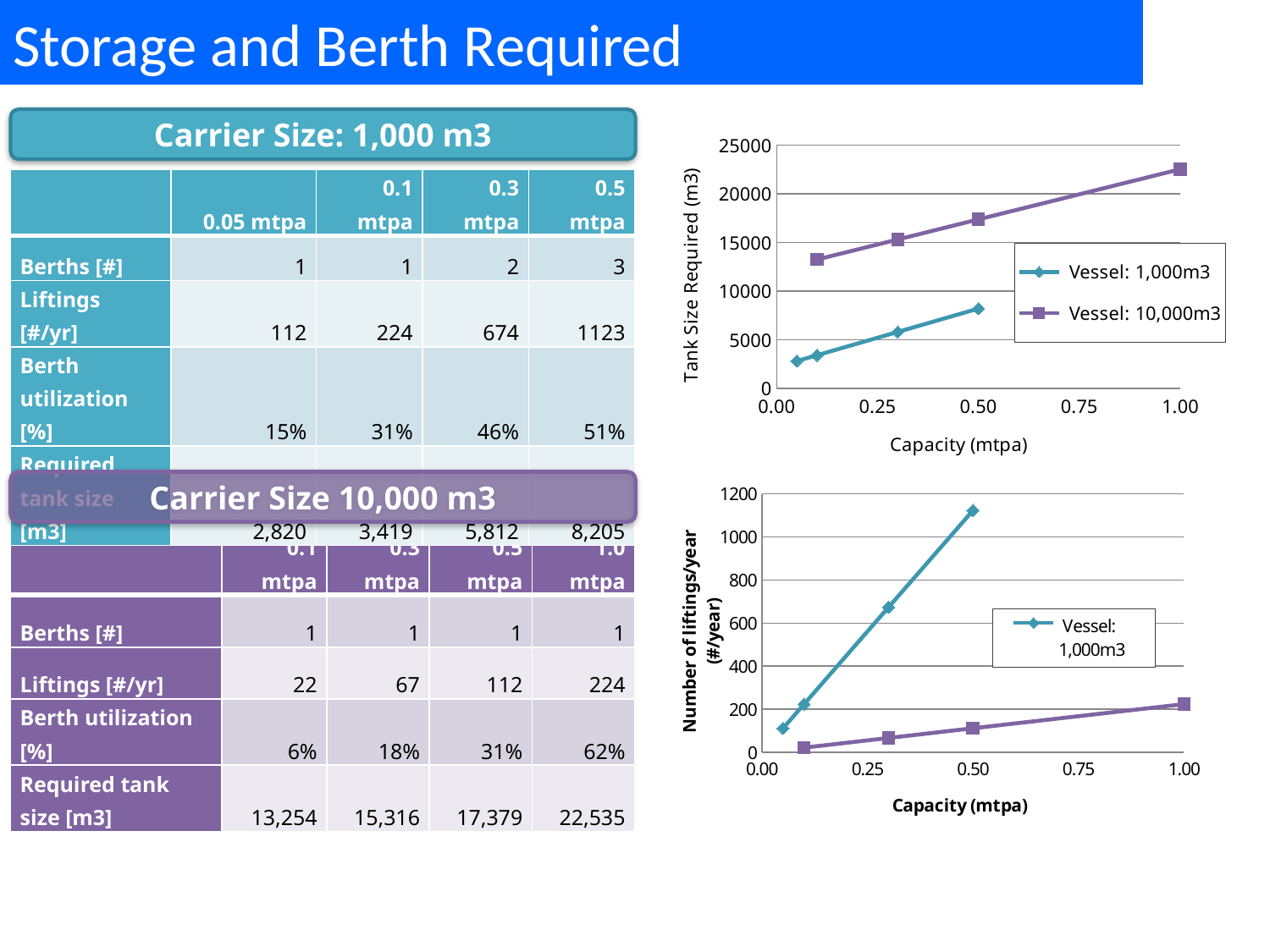
In the top chart (Tank Size Required), which series has the higher value at a capacity of 0.50 mtpa, Vessel: 1,000m3 or Vessel: 10,000m3? Vessel: 10,000m3 In the bottom chart (Number of liftings/year), do the values for Vessel: 1,000m3 rise or fall as capacity increases? rise In the top chart (Tank Size Required), how many data points are plotted for the Vessel: 1,000m3 series? 4 What kind of chart is the top chart (Tank Size Required)? line chart In the top chart (Tank Size Required), is the value for Vessel: 10,000m3 at a capacity of 1.00 mtpa greater or less than 20000? greater In the bottom chart (Number of liftings/year), is the value of the square-marker series at a capacity of 0.50 mtpa greater or less than 200? less In the bottom chart (Number of liftings/year), how many entries does the legend list? 1 What is the x-axis title of the top chart (Tank Size Required)? Capacity (mtpa) In the top chart (Tank Size Required), do the values for Vessel: 10,000m3 rise or fall as capacity increases? rise In the bottom chart (Number of liftings/year), is the value for Vessel: 1,000m3 at a capacity of 0.50 mtpa greater or less than 1000? greater In the top chart (Tank Size Required), how many series does the legend list? 2